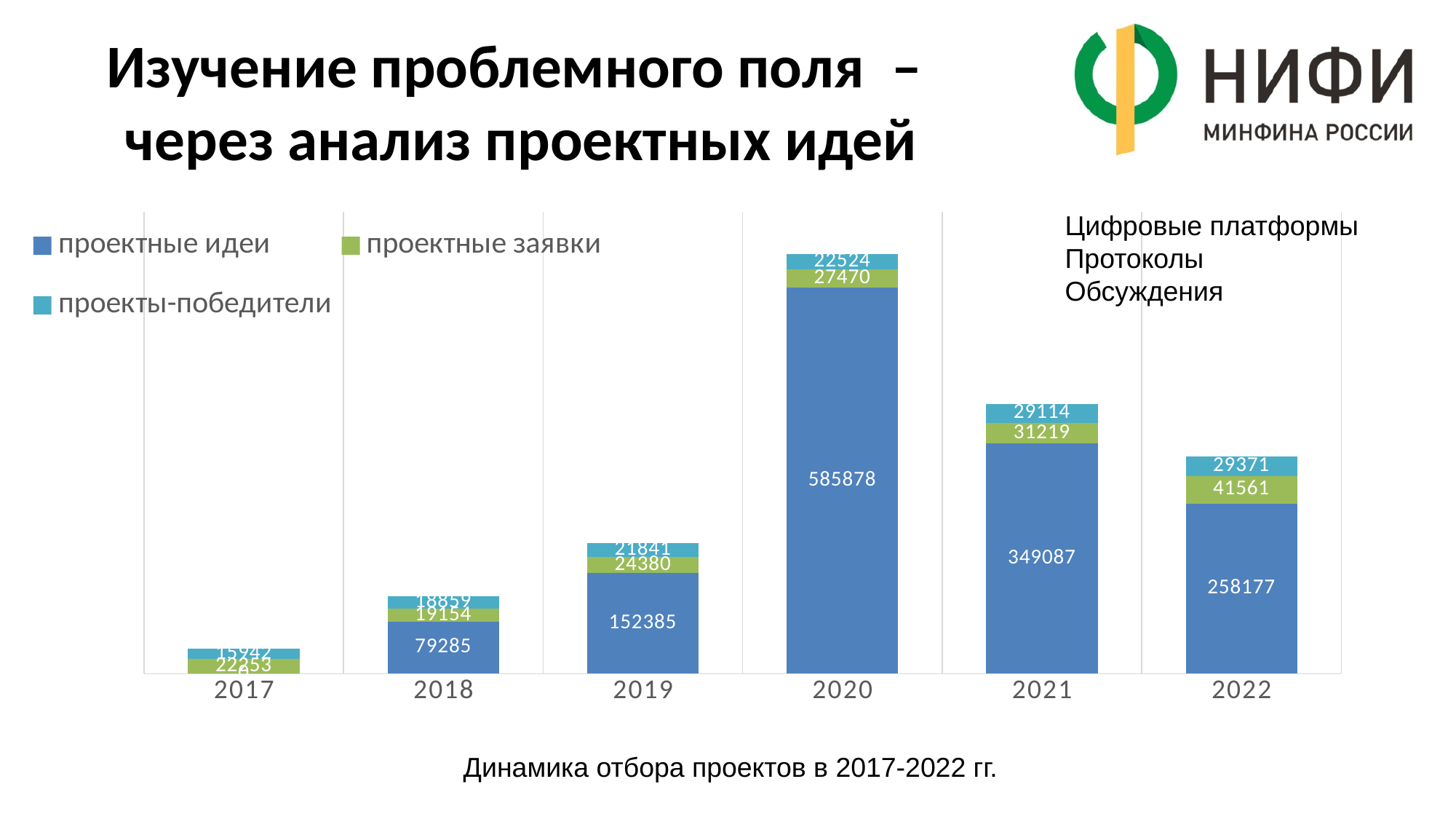
What is the value of проекты-победители for 2019? 21841 What is the caption printed below the chart? Динамика отбора проектов в 2017-2022 гг. Which is larger: проектные идеи in 2021 or in 2022? 2021 What is the value of проектные идеи for 2020? 585878 In which year is the value of проектные заявки the highest? 2022 In which year is the value of проектные идеи the highest? 2020 What is the difference between проектные идеи in 2020 and in 2021? 236791 What is the value of проектные заявки for 2022? 41561 What kind of chart is shown on the slide? Stacked bar chart What is the total of the stacked bar for 2021? 409420 How many series does the chart legend list? 3 How many years are shown on the x axis of the chart? 6